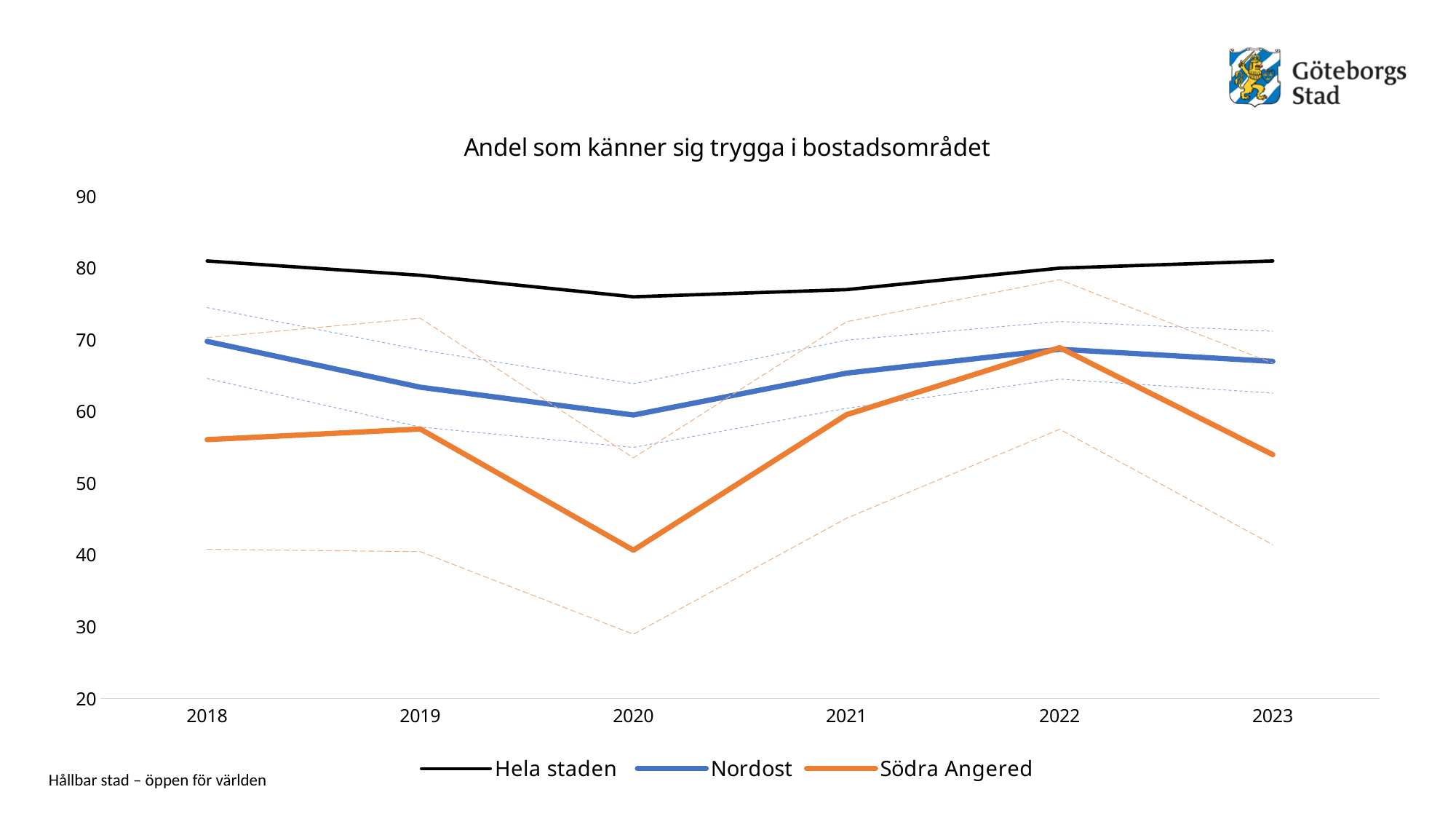
What is the title of the chart? Andel som känner sig trygga i bostadsområdet Is the value for Södra Angered in 2020 greater or less than 50? less Is the value for Hela staden in 2020 greater or less than 80? less How many series does the legend list? 3 In which year is the value for Södra Angered highest? 2022 In which year is the value for Södra Angered lowest? 2020 How many years are shown on the x axis? 6 In which year is the value for Hela staden lowest? 2020 What kind of chart is shown on the slide? line chart Which series is drawn in orange? Södra Angered Does the value for Södra Angered rise or fall from 2022 to 2023? fall Which is larger in 2023, the value for Nordost or the value for Södra Angered? Nordost